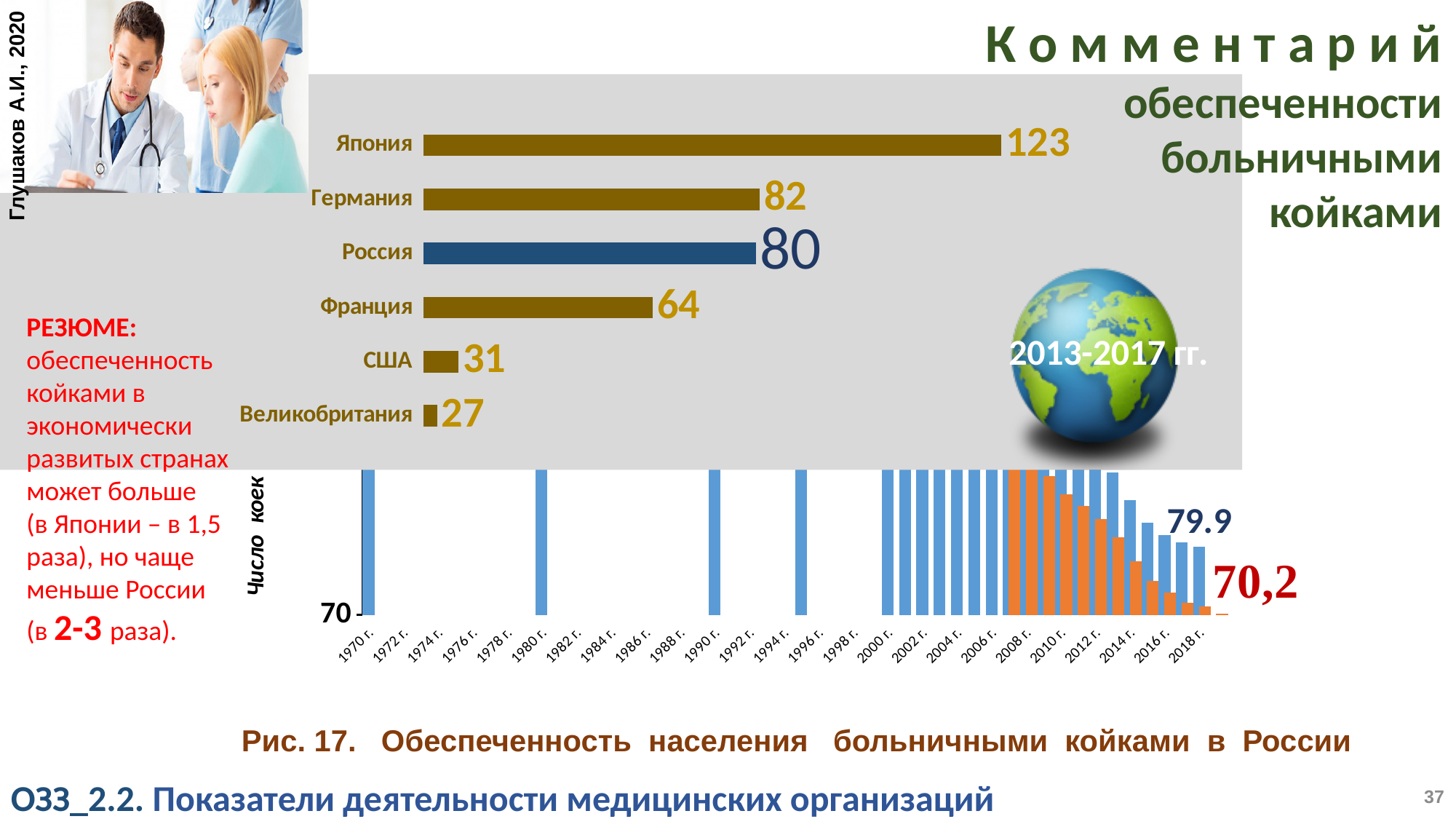
In the upper chart comparing countries, which has a larger value, Франция or США? Франция In the upper chart comparing countries, what is the value for Япония? 123 In the upper chart comparing countries, which country has the lowest value? Великобритания In the upper chart comparing countries, what is the value for Франция? 64 In the upper chart comparing countries, which country has the highest value? Япония What kind of chart is the upper chart comparing countries? bar chart How many countries are shown in the upper chart? 6 In the lower chart (Рис. 17), do the values rise or fall from 2008 to 2018? fall In the upper chart comparing countries, what is the difference between the values for Германия and Франция? 18 In the upper chart comparing countries, what is the difference between the values for Япония and Россия? 43 In the upper chart comparing countries, what is the value for США? 31 In the upper chart comparing countries, what is the value for Россия? 80